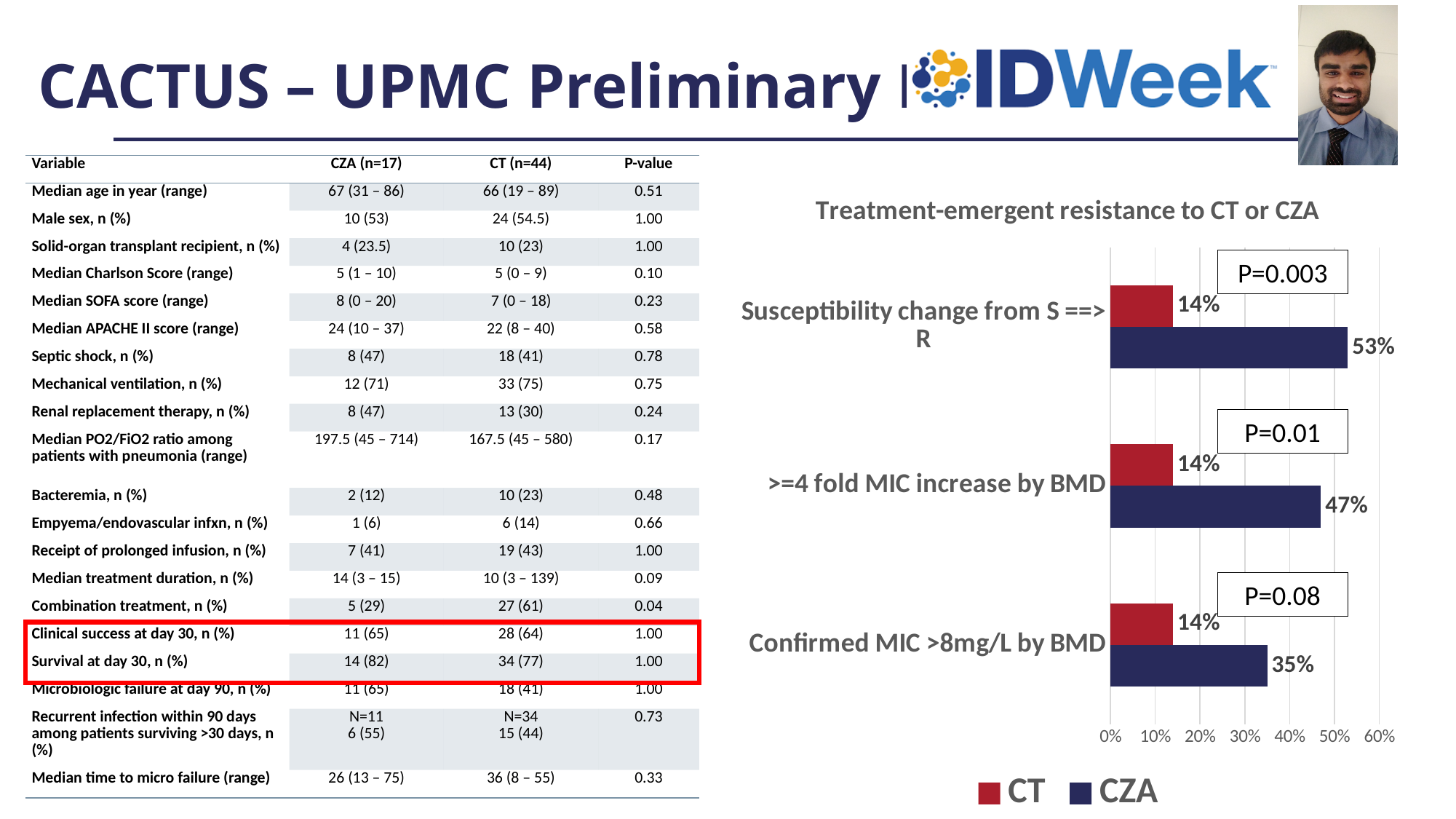
Which category has the lowest CZA value? Confirmed MIC >8mg/L by BMD Which category has the highest CZA value? Susceptibility change from S ==> R Which colour represents the CZA series in the chart? dark blue What is the CZA value for 'Confirmed MIC >8mg/L by BMD'? 35% For 'Confirmed MIC >8mg/L by BMD', which series has the larger value, CT or CZA? CZA What type of chart is shown on the slide? bar chart What is the CZA value for 'Susceptibility change from S ==> R'? 53% What is the title of the chart? Treatment-emergent resistance to CT or CZA What is the CT value for '>=4 fold MIC increase by BMD'? 14% How many series does the chart legend list? 2 What is the difference between the CZA and CT values for '>=4 fold MIC increase by BMD'? 33% How many categories are shown on the chart? 3